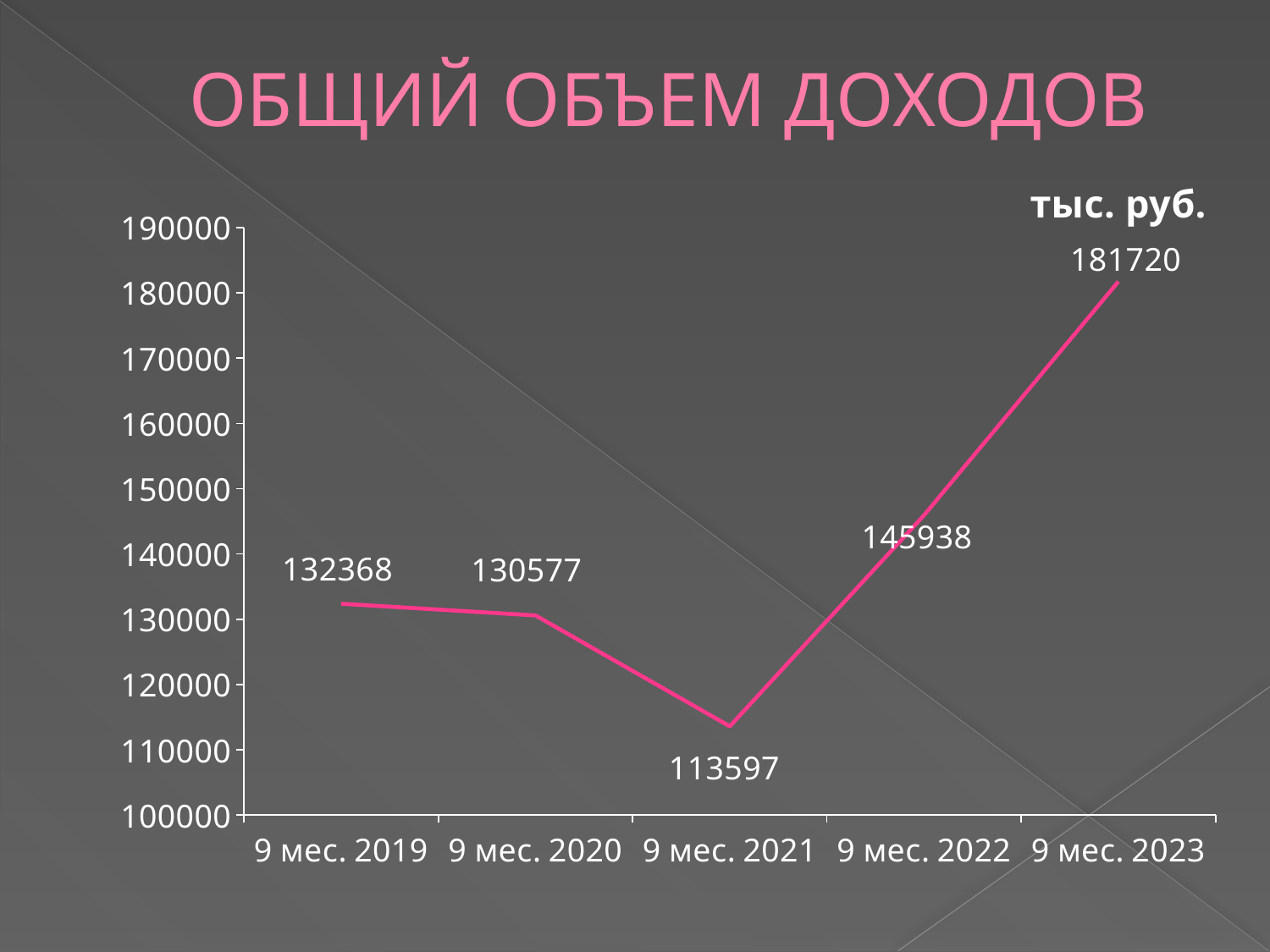
What is the difference between the values for 9 мес. 2019 and 9 мес. 2020? 1791 What is the difference between the values for 9 мес. 2023 and 9 мес. 2022? 35782 Which is larger, the value for 9 мес. 2022 or the value for 9 мес. 2020? 9 мес. 2022 What is the title of the chart? ОБЩИЙ ОБЪЕМ ДОХОДОВ Is the value for 9 мес. 2021 greater or less than 120000? less Which period has the lowest value? 9 мес. 2021 What is the value for 9 мес. 2021? 113597 What is the value for 9 мес. 2023? 181720 How many periods are plotted on the chart? 5 What kind of chart is shown on the slide? line chart Which period has the highest value? 9 мес. 2023 What is the value for 9 мес. 2019? 132368